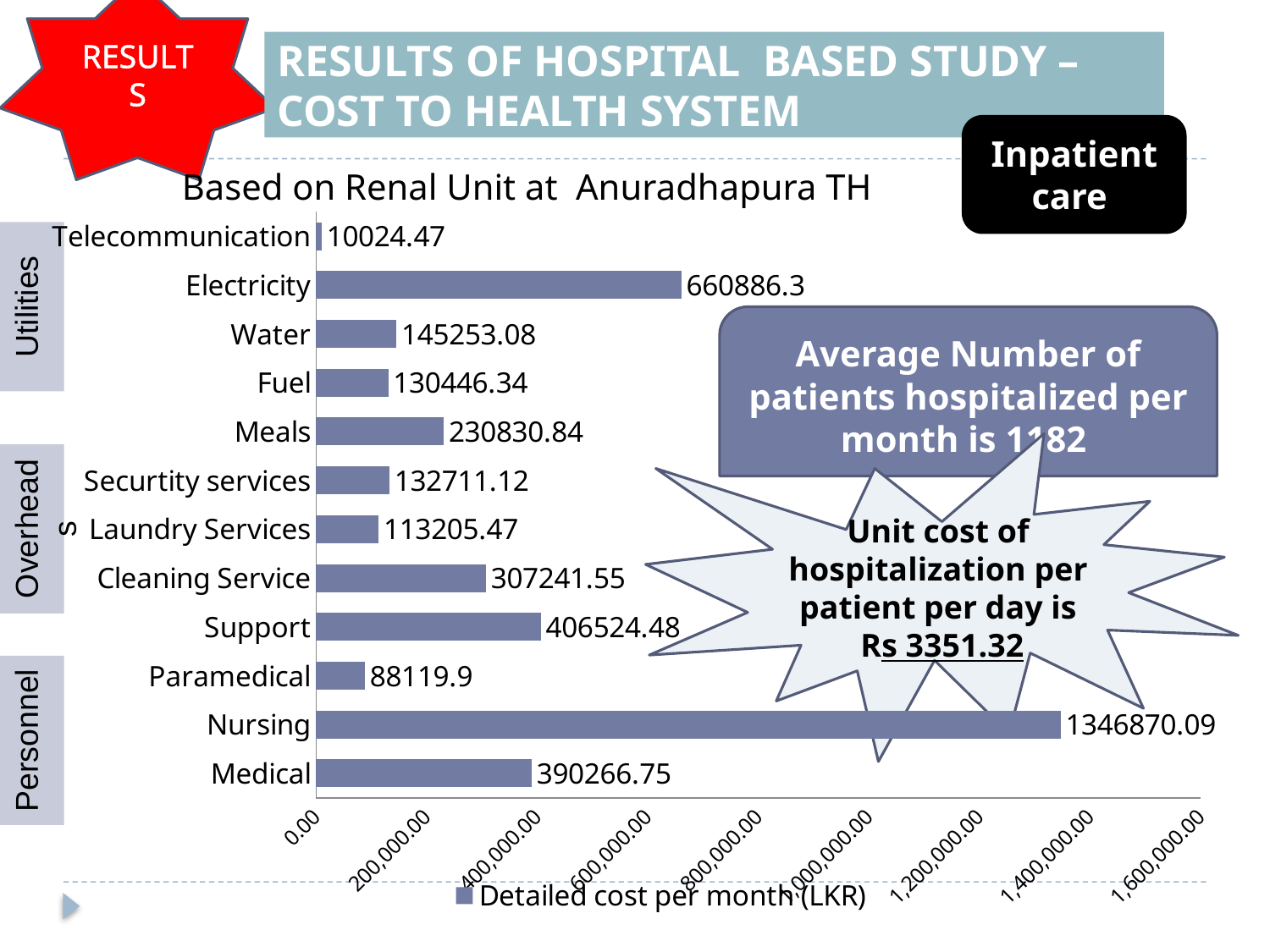
What is the difference between the Electricity cost and the Water cost? 515633.22 How many categories are shown in the chart? 12 What is the detailed cost per month for Electricity? 660886.3 What is the difference between the Support cost and the Medical cost? 16257.73 Which category has the lowest detailed cost per month? Telecommunication Is the value for Nursing greater or less than 1,200,000.00? greater What is the detailed cost per month for Laundry Services? 113205.47 How many series does the legend list? 1 Which category has the highest detailed cost per month? Nursing Which has a higher detailed cost per month, Cleaning Service or Meals? Cleaning Service What is the detailed cost per month for Nursing? 1346870.09 What kind of chart is shown on the slide? Bar chart